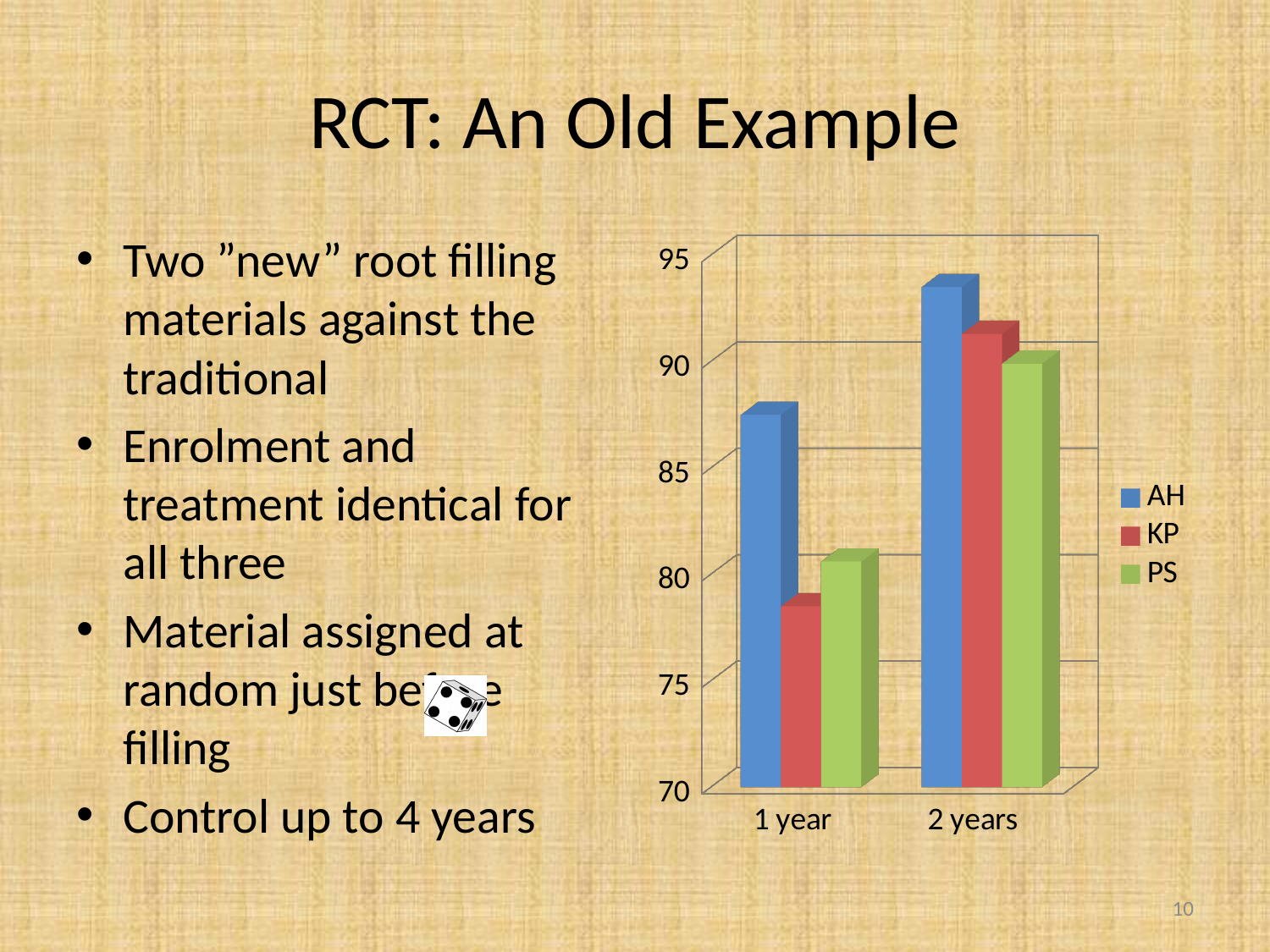
Which colour represents the PS series in the chart? green How many categories are shown on the x axis of the chart? 2 Does the value for KP rise or fall from 1 year to 2 years? rise Is the value for AH at 2 years greater or less than 90? greater How many series does the chart legend list? 3 Is the value for AH at 1 year greater or less than 85? greater Which series has the highest value at 2 years? AH Which series has the highest value at 1 year? AH Which series has the lowest value at 1 year? KP Is the value for KP at 1 year greater or less than 80? less Which is larger, the value for PS at 1 year or the value for PS at 2 years? PS at 2 years What kind of chart is shown on the slide? bar chart